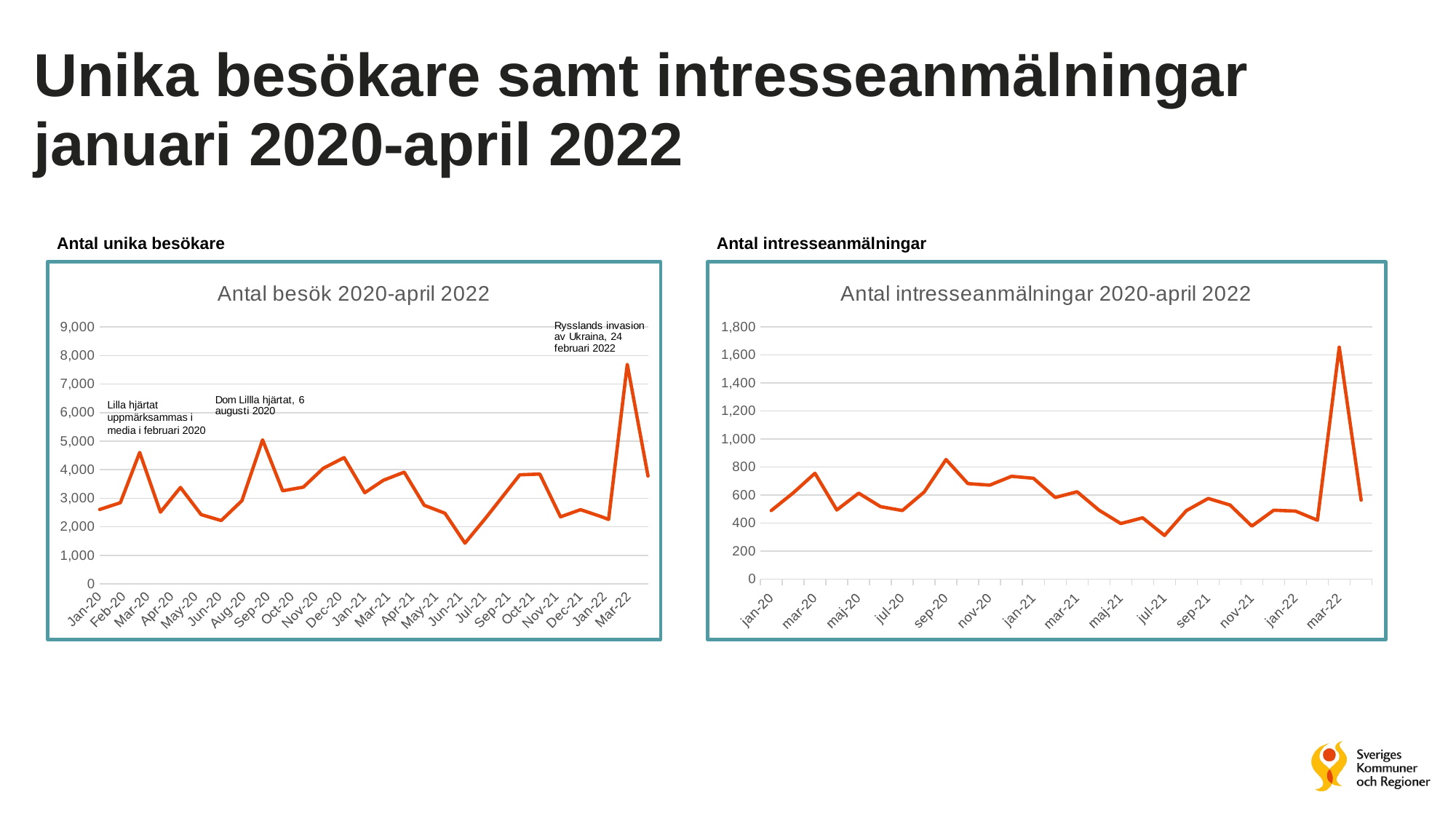
What event does the annotation near the Mar-22 peak in the 'Antal besök 2020-april 2022' chart refer to? Rysslands invasion av Ukraina, 24 februari 2022 In the 'Antal besök 2020-april 2022' chart, which month has the lowest value? Jul-21 In the 'Antal intresseanmälningar 2020-april 2022' chart, which month has the highest value? mar-22 In the 'Antal besök 2020-april 2022' chart, is the value for Mar-22 greater or less than 7,000? greater What kind of chart is the 'Antal intresseanmälningar 2020-april 2022' chart on the right? line chart In the 'Antal besök 2020-april 2022' chart, is the value for Jun-21 greater or less than 2,000? greater In the 'Antal besök 2020-april 2022' chart, which month has the highest value? Mar-22 What kind of chart is the 'Antal besök 2020-april 2022' chart on the left? line chart In the 'Antal intresseanmälningar 2020-april 2022' chart, is the value for mar-22 greater or less than 1,400? greater In the 'Antal besök 2020-april 2022' chart, which is larger, the value for Sep-20 or the value for Jun-20? Sep-20 In the 'Antal intresseanmälningar 2020-april 2022' chart, which month has the lowest value? jul-21